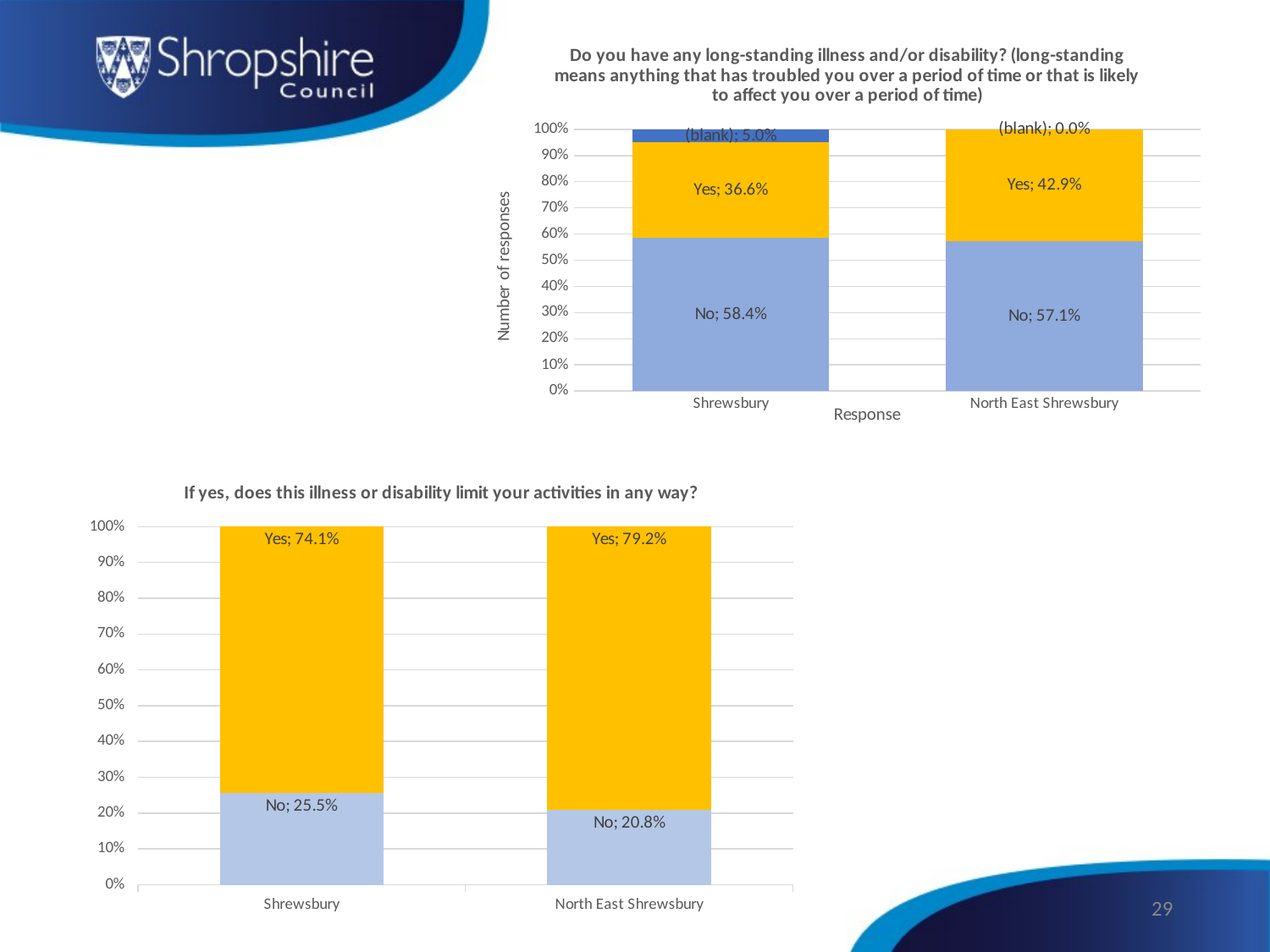
In the bottom chart (does this illness or disability limit your activities), what percentage of Shrewsbury respondents answered Yes? 74.1% In the bottom chart (does this illness or disability limit your activities), what percentage of North East Shrewsbury respondents answered No? 20.8% In the top chart (long-standing illness and/or disability), what percentage of North East Shrewsbury respondents answered Yes? 42.9% In the top chart, what is the label on the vertical axis? Number of responses In the bottom chart (does this illness or disability limit your activities), which area has the higher Yes percentage? North East Shrewsbury In the top chart (long-standing illness and/or disability), what is the difference between the Yes percentages for North East Shrewsbury and Shrewsbury? 6.3% In the bottom chart (does this illness or disability limit your activities), what is the difference between the No percentages for Shrewsbury and North East Shrewsbury? 4.7% In the top chart (long-standing illness and/or disability), how many areas are shown on the x axis? 2 In the top chart (long-standing illness and/or disability), what is the (blank) percentage for Shrewsbury? 5.0% What type of chart is the bottom chart (does this illness or disability limit your activities)? Stacked bar chart In the top chart (long-standing illness and/or disability), what percentage of Shrewsbury respondents answered No? 58.4% In the top chart (long-standing illness and/or disability), which area has the higher Yes percentage, Shrewsbury or North East Shrewsbury? North East Shrewsbury